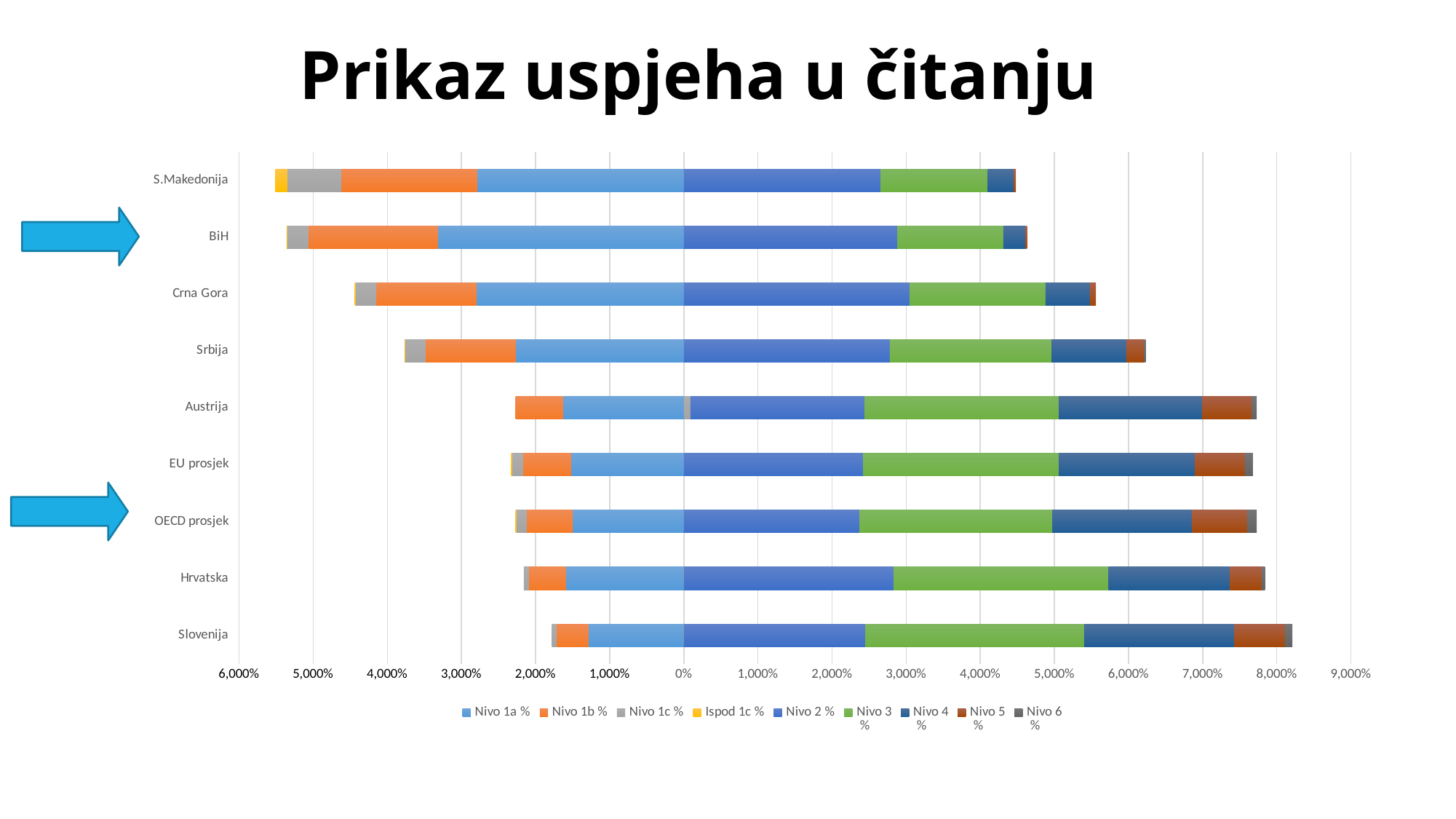
Which colour represents the series 'Nivo 3 %' in the chart? Green Which category's bar extends furthest to the right (positive side) of the 0% axis? Slovenija Which bar extends further to the left of 0%: Srbija or Austrija? Srbija Is the right-hand end of the S.Makedonija bar greater or less than 5,000%? less Is the right-hand end of the Slovenija bar greater or less than 8,000%? greater Which bar extends further to the right of 0%: Hrvatska or S.Makedonija? Hrvatska What kind of chart is shown on the slide? Stacked bar chart Is the left-hand end of the Slovenija bar greater or less than 2,000%? less What is the title of the chart? Prikaz uspjeha u čitanju How many countries or averages are listed on the vertical axis of the chart? 9 How many series does the chart legend list? 9